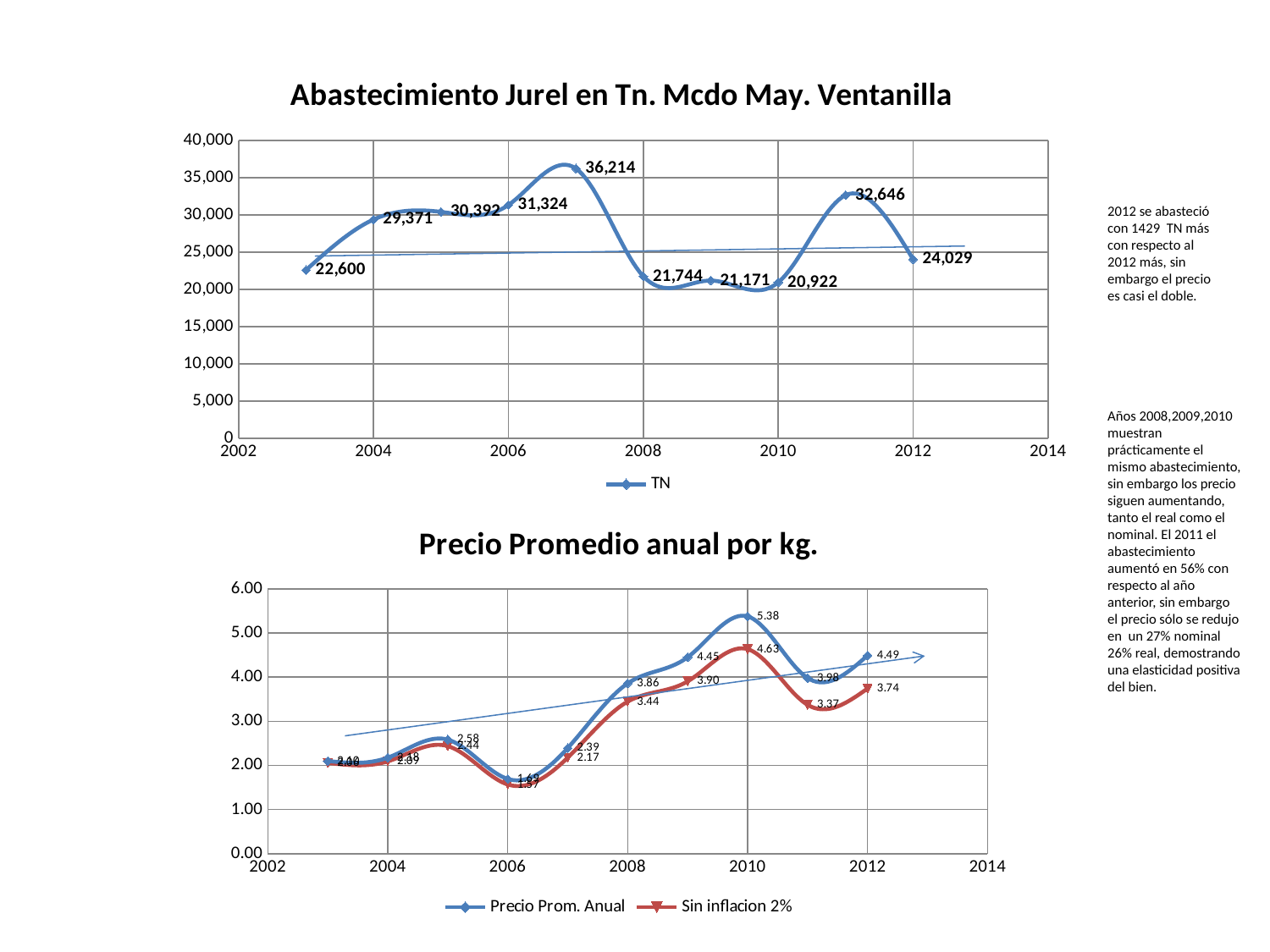
In the chart 'Abastecimiento Jurel en Tn. Mcdo May. Ventanilla', what is the TN value for 2007? 36,214 In the chart 'Abastecimiento Jurel en Tn. Mcdo May. Ventanilla', how many data points are plotted for the TN series? 10 In the chart 'Abastecimiento Jurel en Tn. Mcdo May. Ventanilla', which year has the highest TN value? 2007 In the chart 'Precio Promedio anual por kg.', how many series does the legend list? 2 In the chart 'Abastecimiento Jurel en Tn. Mcdo May. Ventanilla', what is the difference between the TN values for 2011 and 2012? 8,617 In the chart 'Abastecimiento Jurel en Tn. Mcdo May. Ventanilla', is the TN value for 2008 greater or less than 25,000? less In the chart 'Precio Promedio anual por kg.', what is the value of 'Precio Prom. Anual' for 2010? 5.38 In the chart 'Abastecimiento Jurel en Tn. Mcdo May. Ventanilla', which year has the lowest TN value? 2010 In the chart 'Abastecimiento Jurel en Tn. Mcdo May. Ventanilla', what is the TN value for 2012? 24,029 What kind of chart is 'Precio Promedio anual por kg.'? line chart In the chart 'Precio Promedio anual por kg.', what is the value of 'Sin inflacion 2%' for 2012? 3.74 In the chart 'Precio Promedio anual por kg.', which is larger in 2011: 'Precio Prom. Anual' or 'Sin inflacion 2%'? Precio Prom. Anual